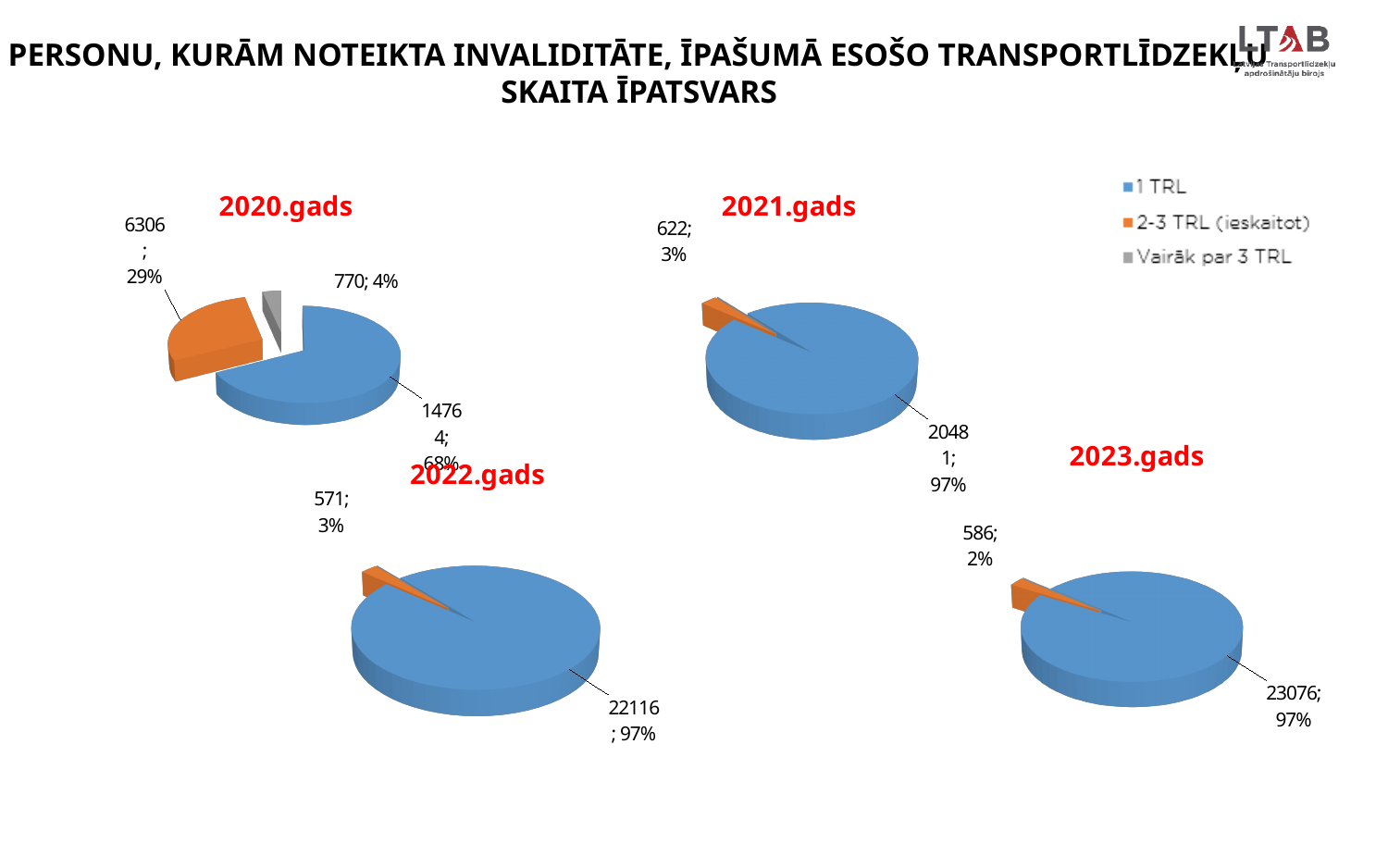
In the 2022.gads chart, which slice is the largest? 1 TRL In the 2020.gads chart, what is the value for the 1 TRL slice? 14764; 68% In the 2021.gads chart, what is the value for the 2-3 TRL (ieskaitot) slice? 622; 3% In the 2020.gads chart, what is the value for the 2-3 TRL (ieskaitot) slice? 6306; 29% In the 2022.gads chart, what is the value for the 1 TRL slice? 22116; 97% How many series does the legend list? 3 In the 2020.gads chart, which slice is the smallest? Vairāk par 3 TRL What is the difference between the 1 TRL value in the 2023.gads chart and the 1 TRL value in the 2022.gads chart? 960 What type of charts are shown on the slide? Pie charts In the 2020.gads chart, what share of the pie does the Vairāk par 3 TRL slice represent? 4% In the 2023.gads chart, what is the value for the 2-3 TRL (ieskaitot) slice? 586; 2% In the 2023.gads chart, what share of the pie does the 1 TRL slice represent? 97%